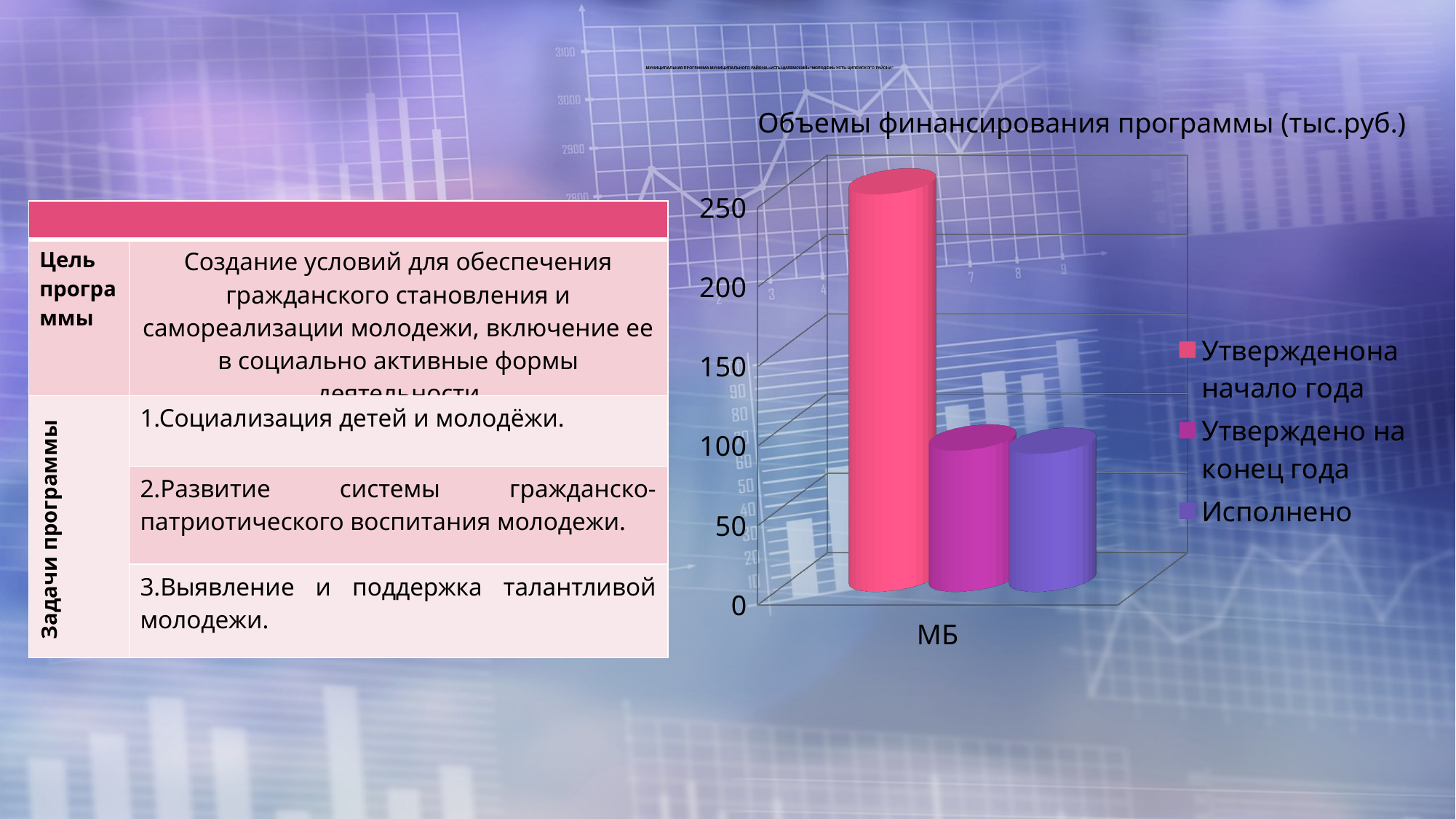
What is the title of the chart? Объемы финансирования программы (тыс.руб.) Which is larger for МБ: Утвержденона начало года or Исполнено? Утвержденона начало года Is the value for Утверждено на конец года greater or less than 200? less Which is larger for МБ: Утвержденона начало года or Утверждено на конец года? Утвержденона начало года How many categories are shown on the x axis of the chart? 1 Is the value for Утверждено на конец года greater or less than 50? greater How many series does the chart legend list? 3 Is the value for Утвержденона начало года greater or less than 200? greater What is the label of the category on the x axis of the chart? МБ Which series has the highest value for МБ? Утвержденона начало года What kind of chart is shown on the slide? bar chart